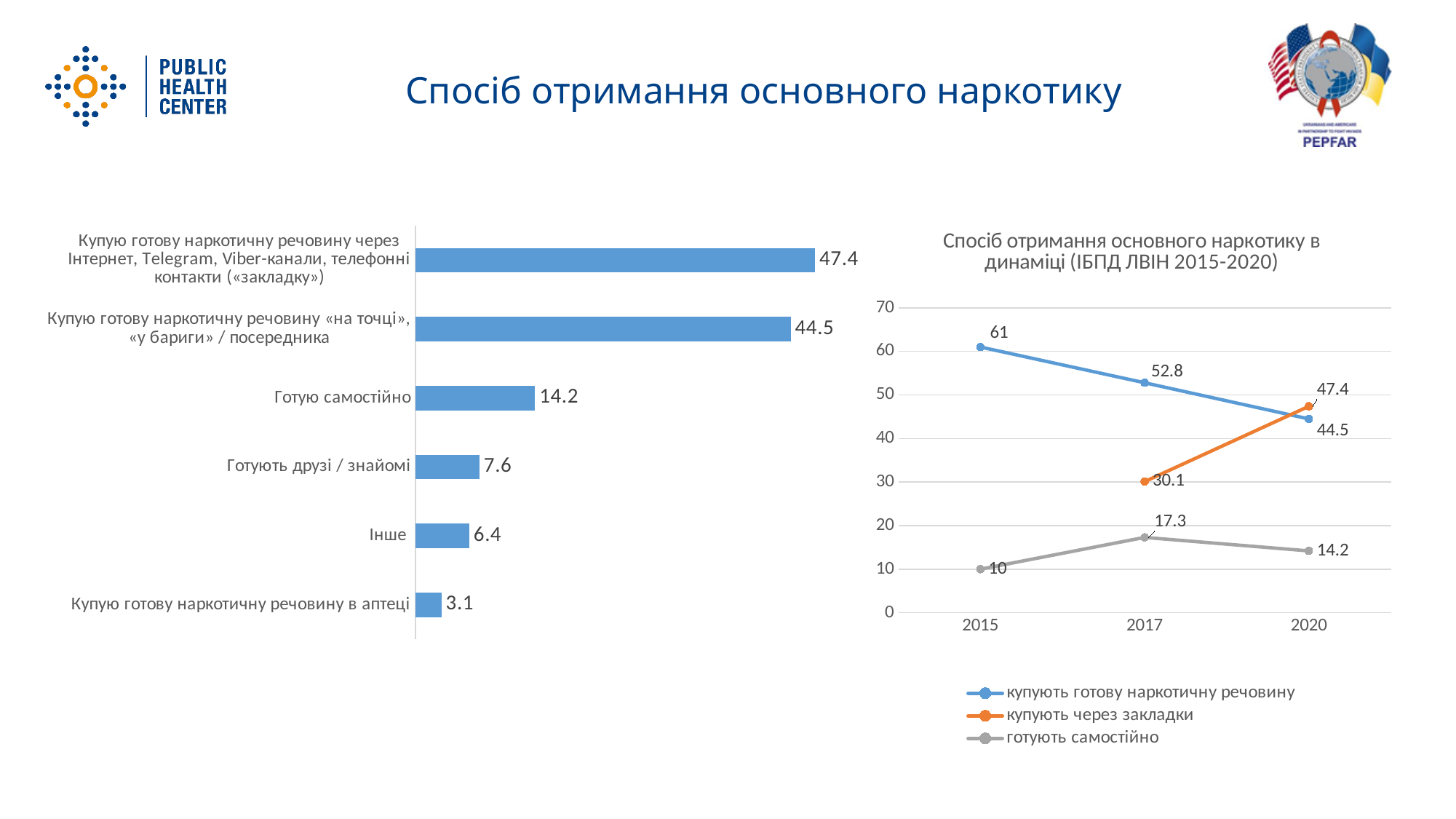
In the line chart on the right, what is the value for «купують через закладки» in 2017? 30.1 In the line chart on the right, how many series does the legend list? 3 In the bar chart on the left, what is the value for «Готую самостійно»? 14.2 What kind of chart is the chart on the left? bar chart In the bar chart on the left, what is the difference between «Готують друзі / знайомі» and «Інше»? 1.2 In the line chart on the right, which is larger in 2020: «купують через закладки» or «купують готову наркотичну речовину»? купують через закладки In the line chart on the right, what is the value for «готують самостійно» in 2015? 10 In the line chart on the right, does the value for «купують готову наркотичну речовину» rise or fall from 2015 to 2020? fall In the bar chart on the left, how many categories are shown? 6 In the line chart on the right, what is the difference between the 2015 and 2017 values for «купують готову наркотичну речовину»? 8.2 In the bar chart on the left, which category has the highest value? Купую готову наркотичну речовину через Інтернет, Telegram, Viber-канали, телефонні контакти («закладку») In the bar chart on the left, which category has the lowest value? Купую готову наркотичну речовину в аптеці